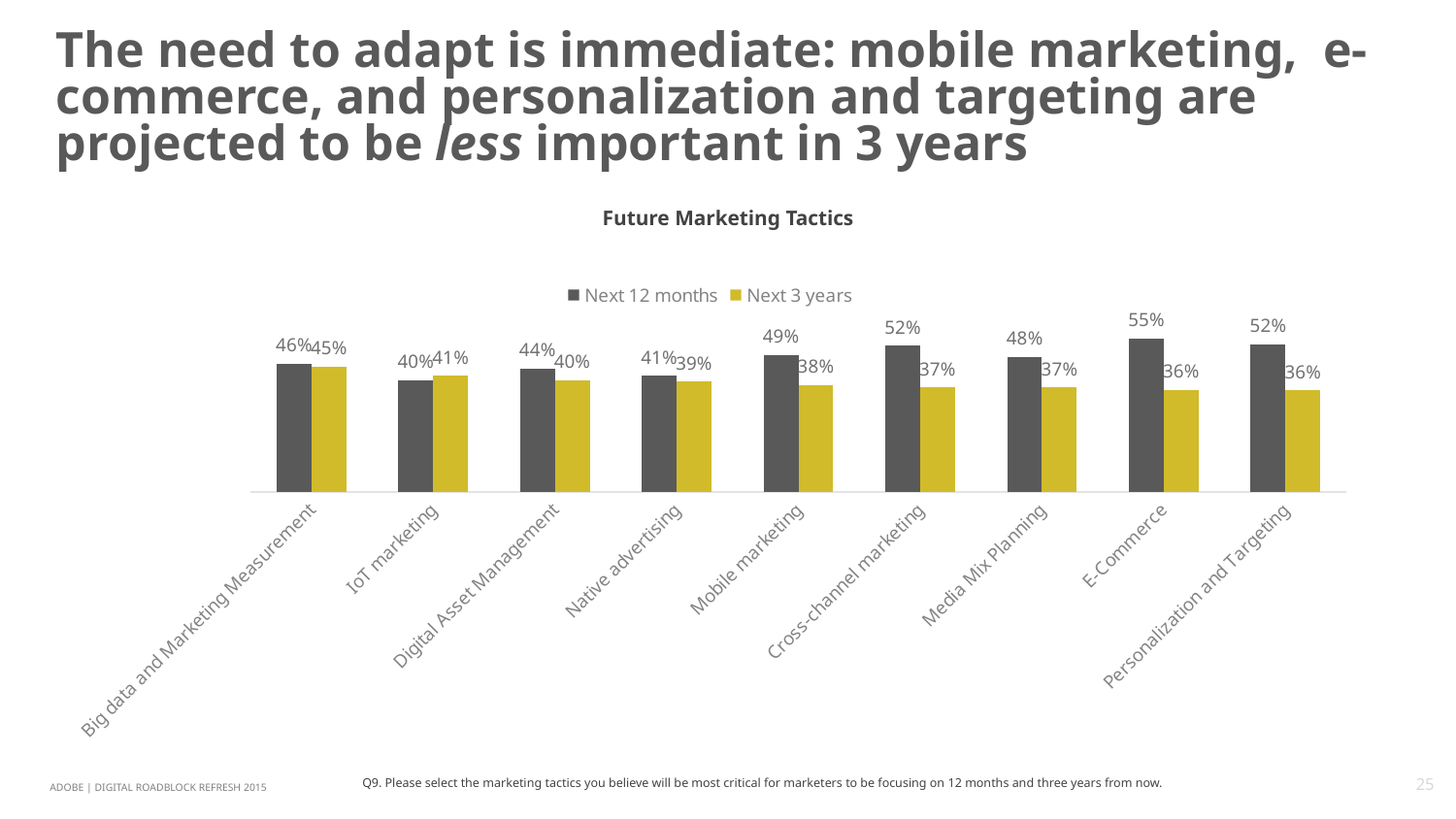
Which category has the highest 'Next 3 years' value? Big data and Marketing Measurement What is the title of the chart? Future Marketing Tactics Which category has the highest 'Next 12 months' value? E-Commerce What is the 'Next 12 months' value for E-Commerce? 55% Which category has the lowest 'Next 12 months' value? IoT marketing What is the difference between the 'Next 12 months' and 'Next 3 years' values for E-Commerce? 19% What is the 'Next 12 months' value for Cross-channel marketing? 52% For IoT marketing, which is larger: the 'Next 12 months' value or the 'Next 3 years' value? Next 3 years What kind of chart is shown on the slide? Bar chart How many categories are shown on the x axis? 9 How many series does the legend list? 2 What is the 'Next 3 years' value for Mobile marketing? 38%